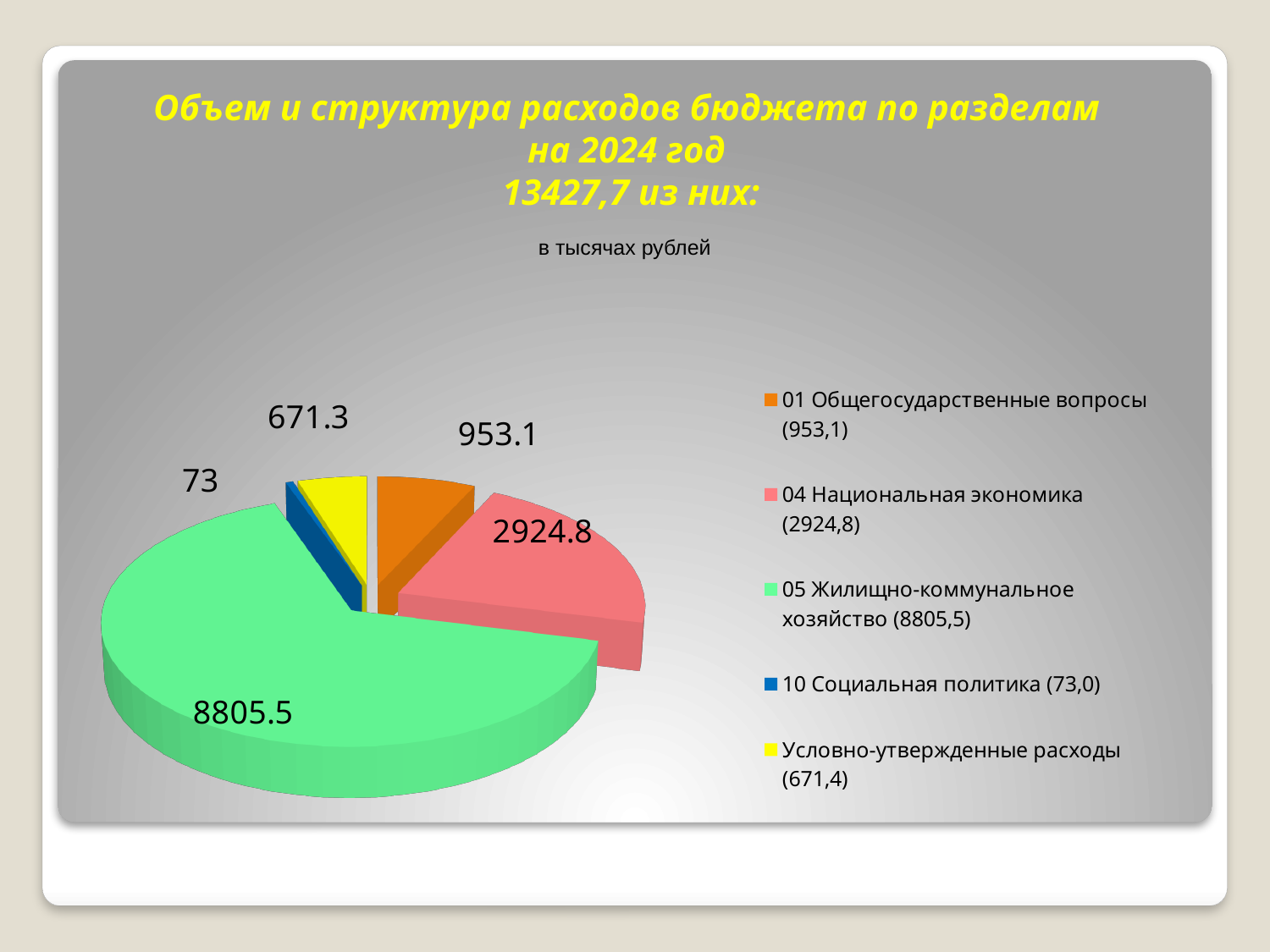
What kind of chart is shown on the slide? Pie chart What value is shown for the 10 Социальная политика slice? 73 How many slices does the pie chart have? 5 What value is shown for the 05 Жилищно-коммунальное хозяйство slice of the pie chart? 8805.5 What colour is the slice for 10 Социальная политика? Blue What is the difference between the values for 05 Жилищно-коммунальное хозяйство and 04 Национальная экономика? 5880.7 What value is shown for the 01 Общегосударственные вопросы slice? 953.1 Which category has the smallest slice of the pie? 10 Социальная политика What total amount of expenditures is stated in the slide title? 13427,7 What value is shown for the 04 Национальная экономика slice? 2924.8 Which category has the largest slice of the pie? 05 Жилищно-коммунальное хозяйство Which is larger: the value for 01 Общегосударственные вопросы or for Условно-утвержденные расходы? 01 Общегосударственные вопросы